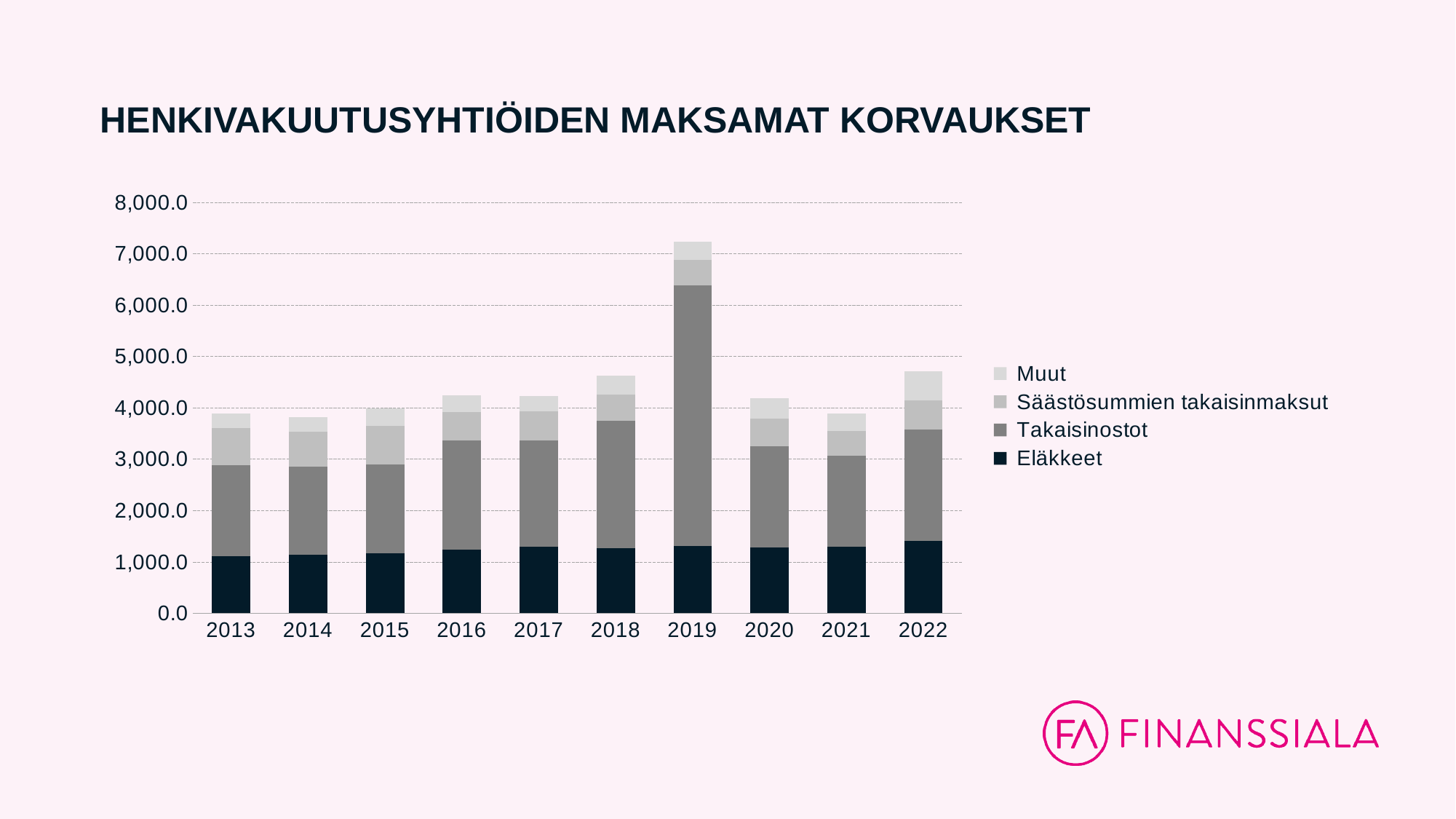
Is the total value for 2022 greater or less than 5,000.0? less How many years are shown on the x axis of the chart? 10 Which year has the larger total bar, 2021 or 2022? 2022 Is the Eläkkeet value for 2022 greater or less than 1,000.0? greater Which year has the larger total bar, 2018 or 2019? 2019 Is the total value for 2019 greater or less than 7,000.0? greater How many series does the legend list? 4 Which year has the highest total bar? 2019 What is the title of the chart? HENKIVAKUUTUSYHTIÖIDEN MAKSAMAT KORVAUKSET What kind of chart is shown on the slide? Stacked bar chart